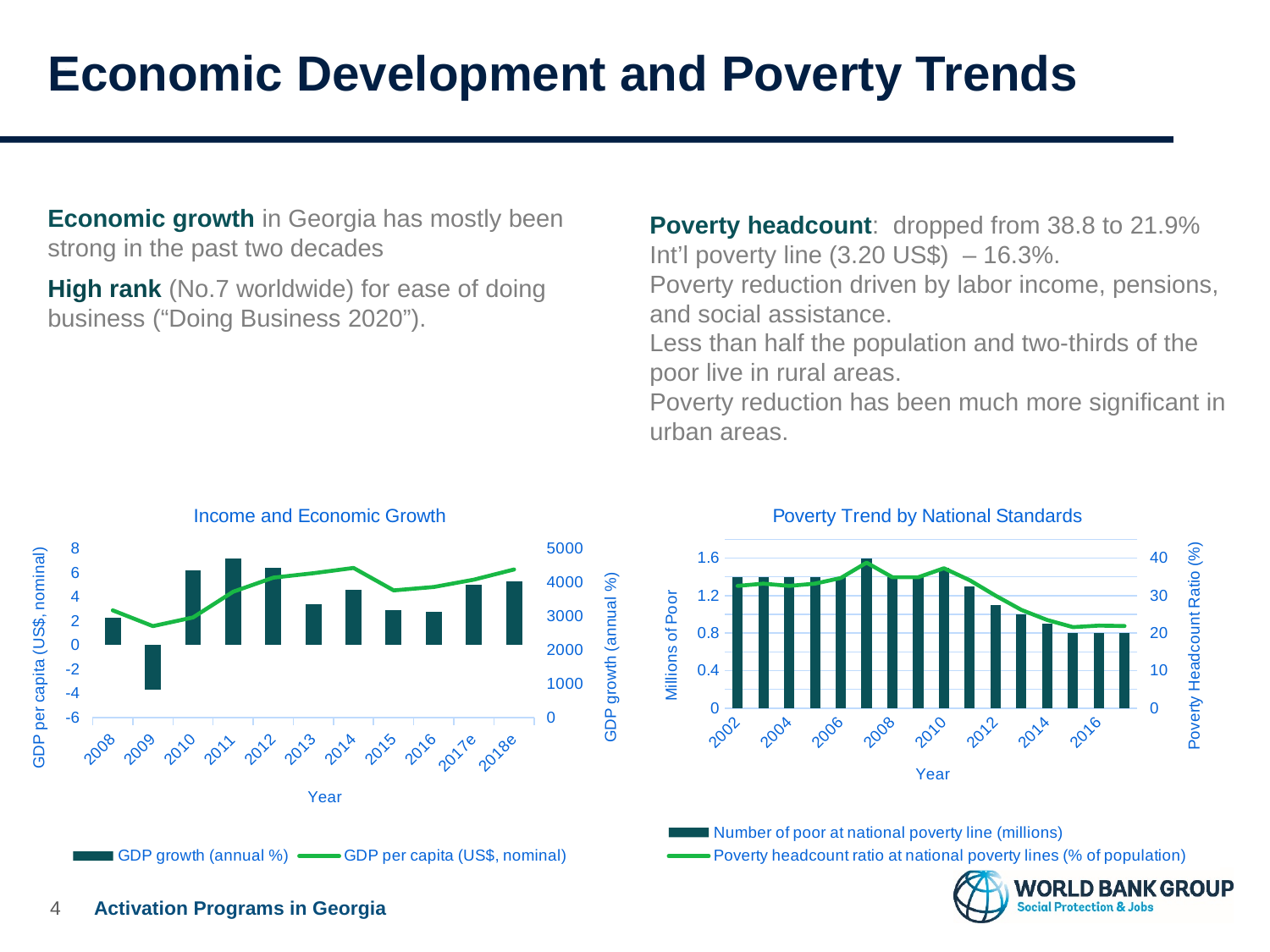
On the 'Income and Economic Growth' chart, how many series does the legend list? 2 On the 'Poverty Trend by National Standards' chart, how many series does the legend list? 2 On the 'Income and Economic Growth' chart, what kind of chart is used to show GDP growth (annual %)? bar chart On the 'Income and Economic Growth' chart, is the GDP per capita (US$, nominal) for 2014 greater or less than 4000? greater On the 'Poverty Trend by National Standards' chart, which is larger: the number of poor in 2007 or in 2015? 2007 On the 'Income and Economic Growth' chart, how many years are shown on the x axis? 11 On the 'Income and Economic Growth' chart, is the GDP growth (annual %) for 2009 greater or less than 0? less On the 'Poverty Trend by National Standards' chart, which year has the highest number of poor at the national poverty line? 2007 On the 'Poverty Trend by National Standards' chart, does the poverty headcount ratio rise or fall between 2010 and 2017? fall On the 'Poverty Trend by National Standards' chart, is the number of poor in 2016 greater or less than 1.2 million? less On the 'Income and Economic Growth' chart, which year has the highest GDP growth (annual %)? 2011 On the 'Income and Economic Growth' chart, which year has the lowest GDP growth (annual %)? 2009